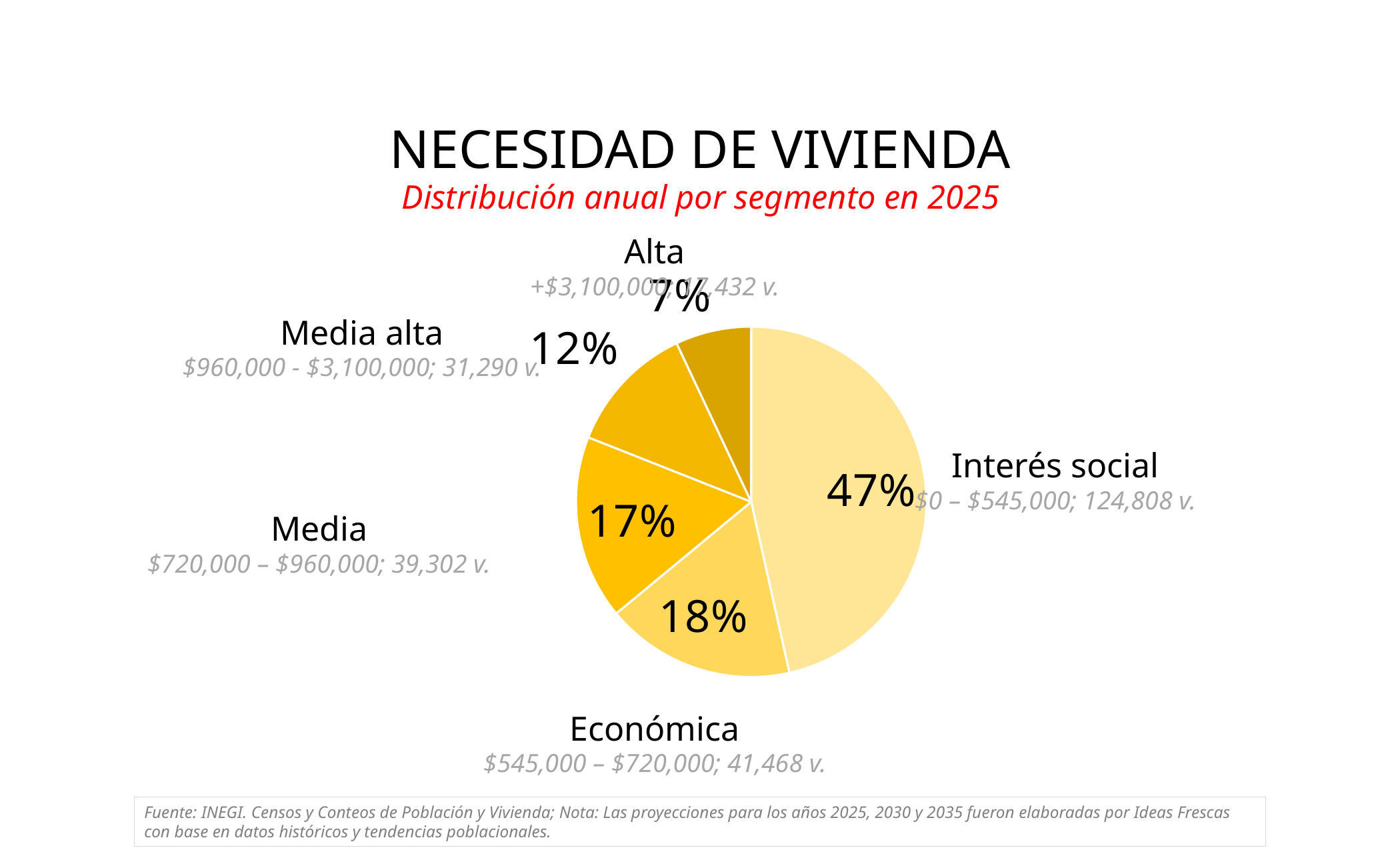
What kind of chart is shown on the slide? pie chart Which segment has the smallest share of the pie? Alta Which segment has the largest share of the pie? Interés social What is the difference in percentage points between the Interés social and Económica segments? 29 What percentage is shown for the Alta segment? 7% What percentage of the pie does the Interés social segment represent? 47% How many segments does the pie chart have? 5 Which segment is larger, Media alta or Alta? Media alta What percentage is shown for the Económica segment? 18% What percentage is shown for the Media alta segment? 12% What is the subtitle shown in red below the chart title? Distribución anual por segmento en 2025 What percentage is shown for the Media segment? 17%